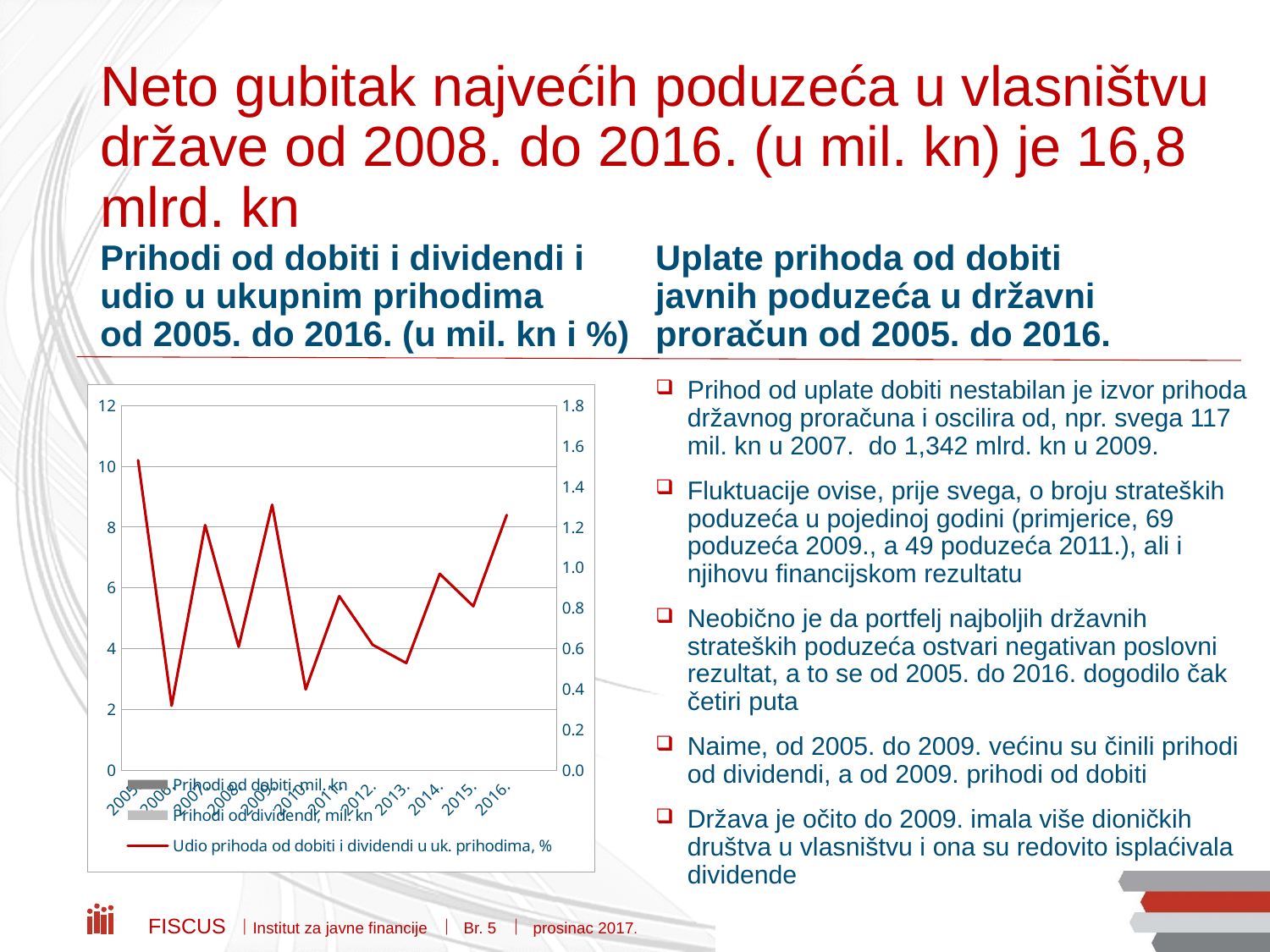
On the right-hand axis, is the value of the share line for 2006. greater or less than 0.4? less Does the share line rise or fall from 2013. to 2014.? rise In which year is the line 'Udio prihoda od dobiti i dividendi u uk. prihodima, %' at its lowest? 2006. On the right-hand axis, is the value of the share line for 2009. greater or less than 1.2? greater On the right-hand axis, is the value of the share line for 2016. greater or less than 1.0? greater Which year has the higher value on the share line, 2007. or 2008.? 2007. How many years are shown along the x axis of the chart? 12 How many series does the chart legend list? 3 What colour is the line for 'Udio prihoda od dobiti i dividendi u uk. prihodima, %'? red What kind of chart is shown on the slide? line chart In which year is the line 'Udio prihoda od dobiti i dividendi u uk. prihodima, %' at its highest? 2005.